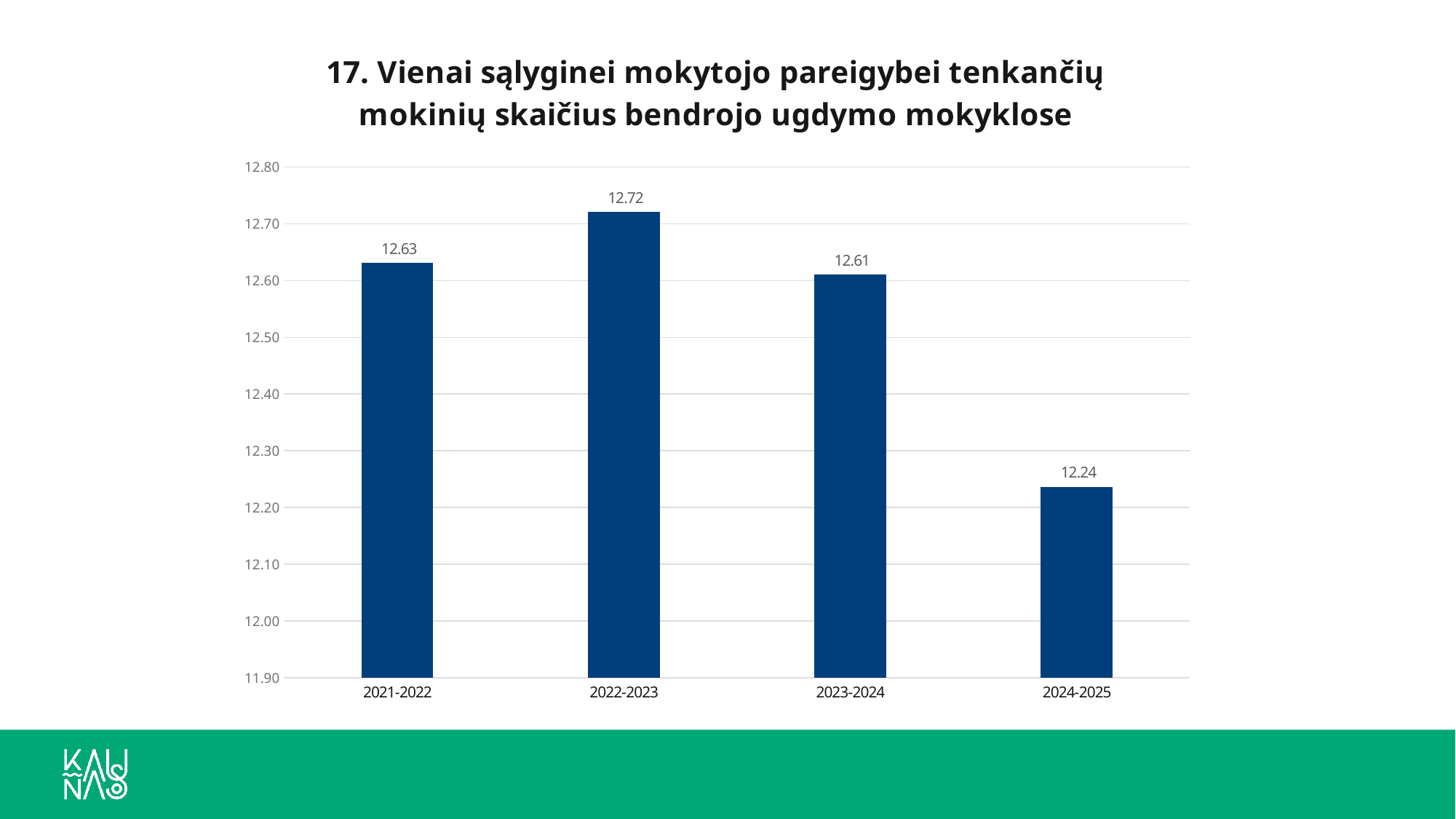
How many school years are shown on the x axis? 4 Is the value for 2024-2025 greater or less than 12.30? less Which school year has the lowest value? 2024-2025 What is the value for 2022-2023? 12.72 What kind of chart is shown on the slide? bar chart What is the value for 2021-2022? 12.63 Which school year has the highest value? 2022-2023 What is the difference between the values for 2022-2023 and 2024-2025? 0.48 Which is larger, the value for 2021-2022 or the value for 2024-2025? 2021-2022 What is the value for 2024-2025? 12.24 What is the value for 2023-2024? 12.61 What is the difference between the values for 2021-2022 and 2023-2024? 0.02